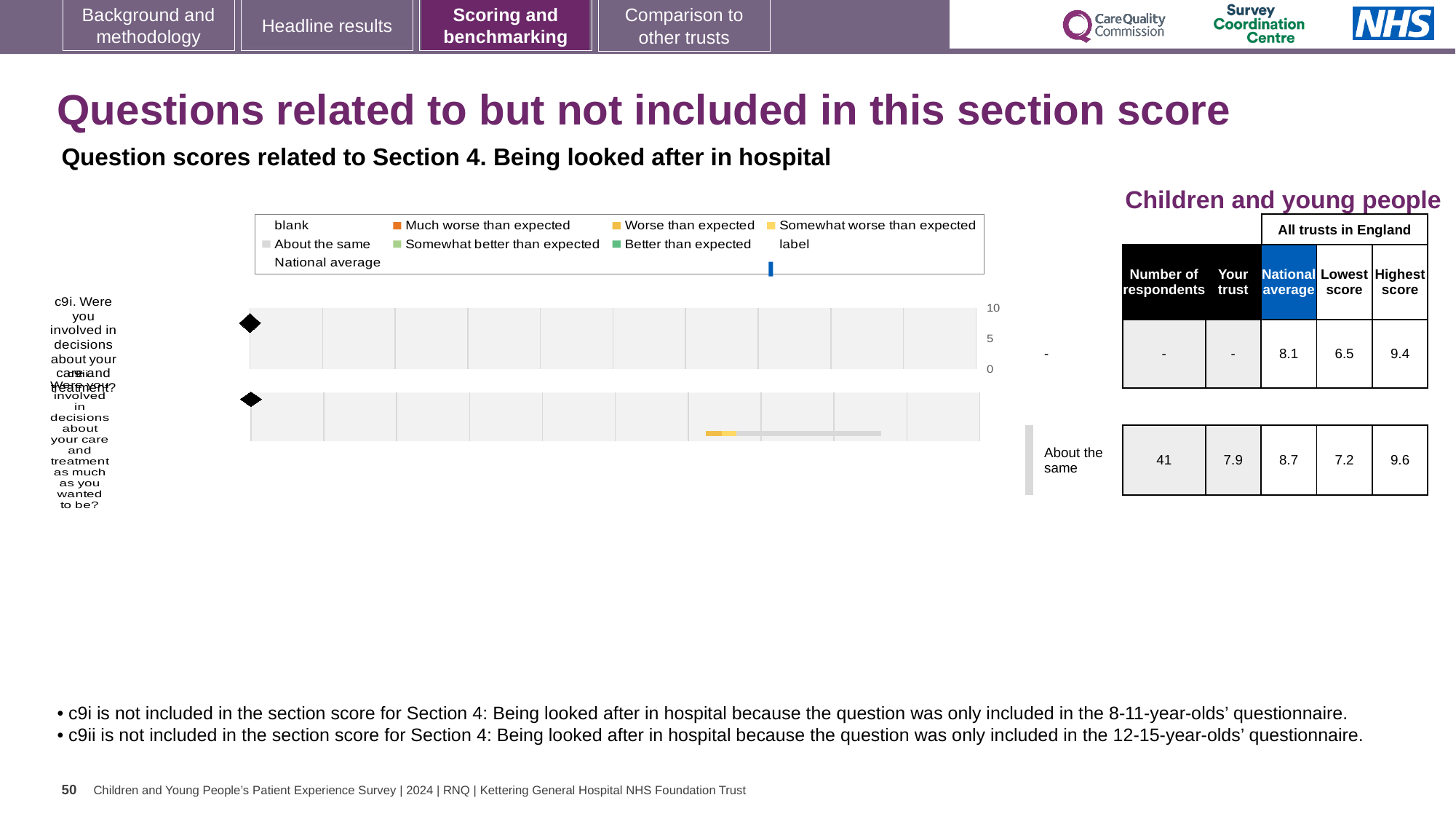
What kind of chart is shown on the slide? bar chart What is the highest score across all trusts in England for question c9i? 9.4 What is the national average score for question c9i? 8.1 What is the highest value shown on the chart's axis? 10 What is the 'Your trust' score for question c9ii? 7.9 How many questions (bars) are plotted in the chart? 2 Which benchmark category is shown for question c9ii in the table next to the chart? About the same What is the number of respondents for question c9ii? 41 Which question has the higher national average, c9i or c9ii? c9ii What is the national average score for question c9ii? 8.7 What is the difference between the highest score and the lowest score for question c9ii? 2.4 For question c9ii, which is larger: the 'Your trust' score or the national average? National average